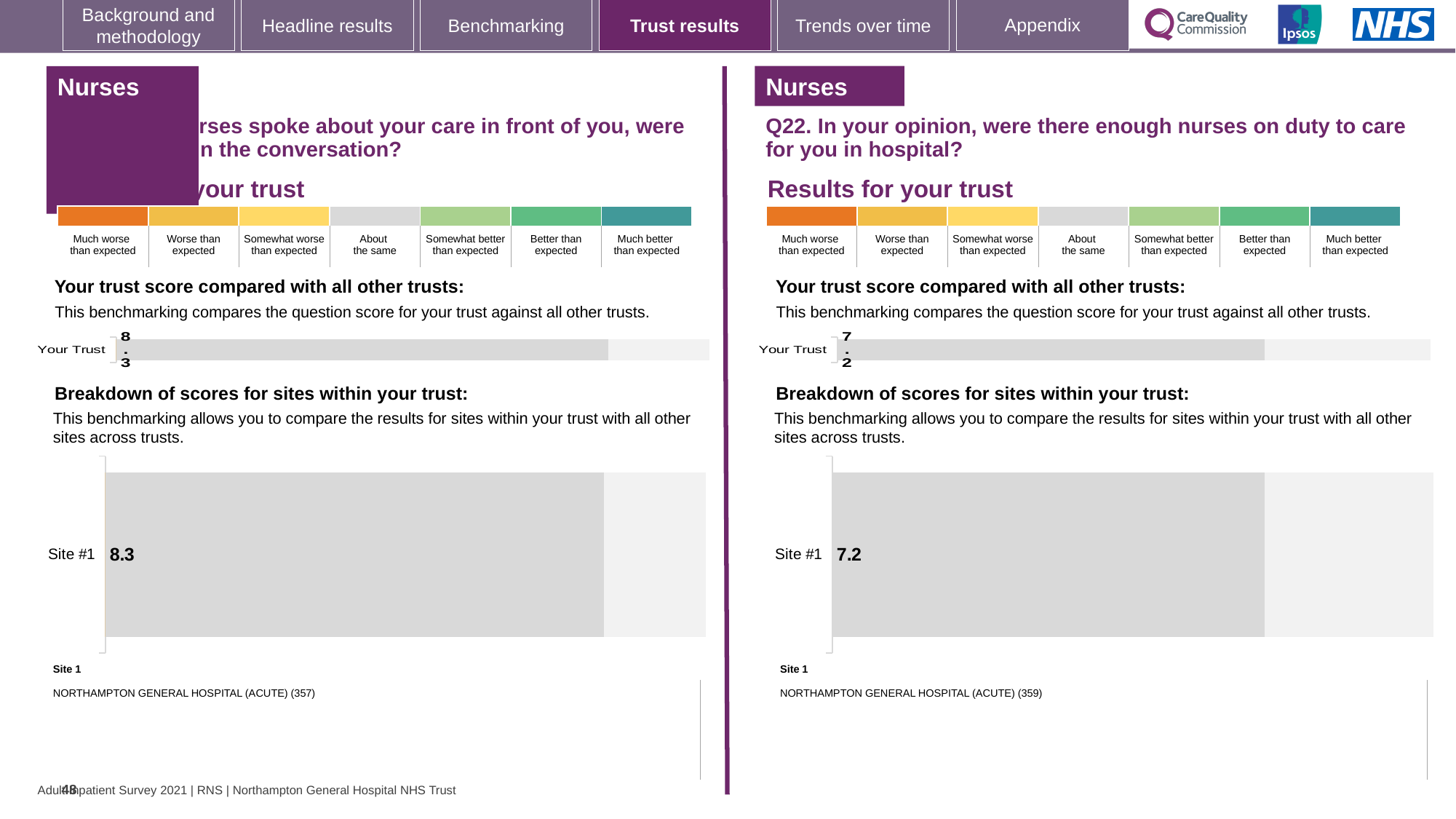
Is the Site #1 score for Q22 greater or less than 8? less What kind of chart is used to show the Site #1 score for Q22? Bar chart How many sites are shown in the left 'Breakdown of scores for sites within your trust' chart? 1 Which site name is listed as Site 1 under the left breakdown chart? NORTHAMPTON GENERAL HOSPITAL (ACUTE) (357) In the left 'Breakdown of scores for sites within your trust' chart, what is the value for Site #1? 8.3 What is the difference between the Site #1 score on the left half of the slide and the Site #1 score for Q22? 1.1 Which site name is listed as Site 1 under the Q22 breakdown chart? NORTHAMPTON GENERAL HOSPITAL (ACUTE) (359) How many sites are shown in the Q22 'Breakdown of scores for sites within your trust' chart? 1 On the left half of the slide, what is the score shown for Your Trust? 8.3 On the right half of the slide (Q22), what is the score shown for Your Trust? 7.2 Which is larger: the Your Trust score on the left half of the slide or the Your Trust score for Q22 on the right? The left half (8.3) In the Q22 'Breakdown of scores for sites within your trust' chart, what is the value for Site #1? 7.2